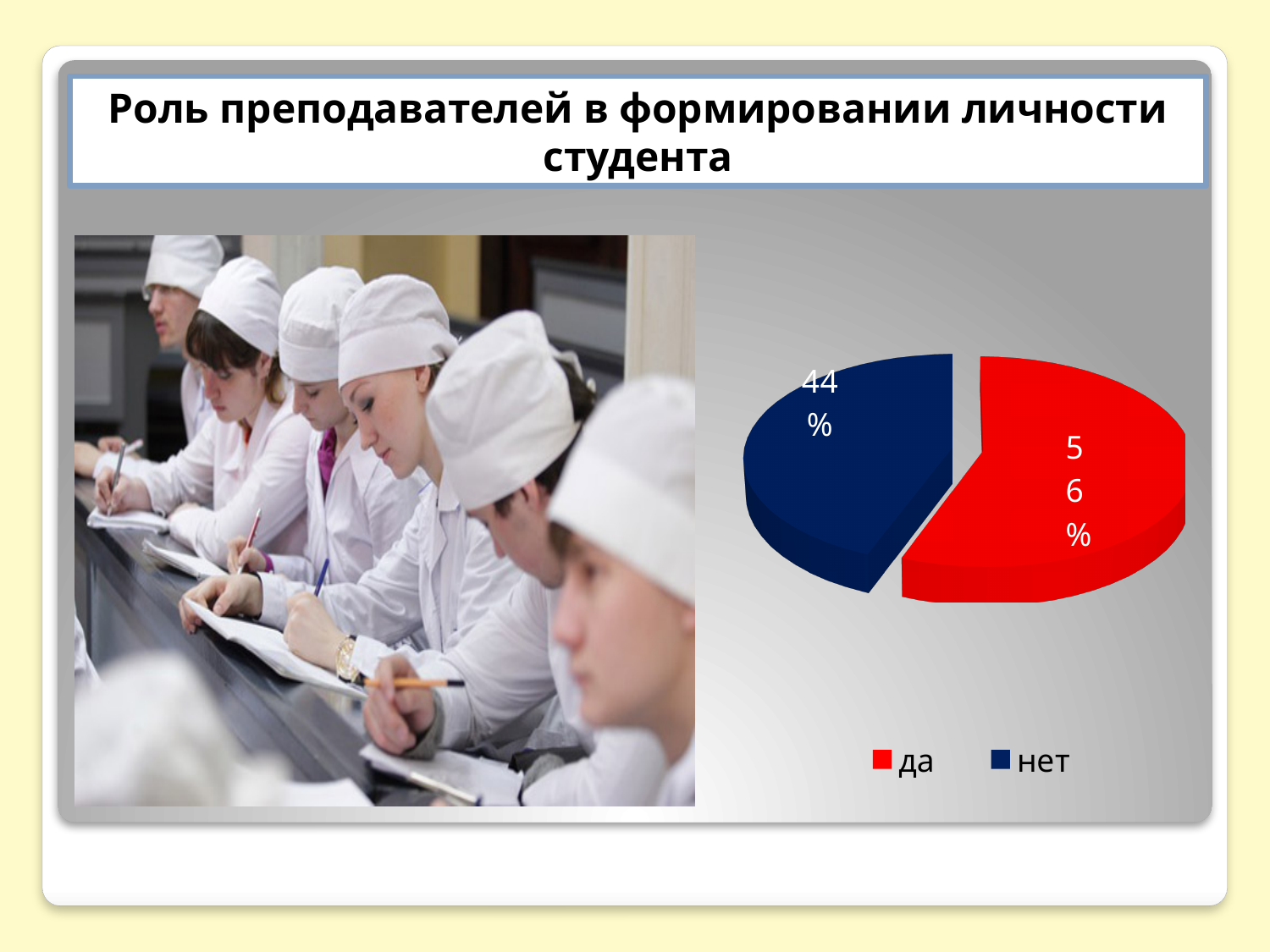
Which slice of the pie chart is the smallest? нет Is the share of the "да" slice greater or less than 50%? greater What is the difference in percentage points between the "да" and "нет" slices? 12 What colour is the "да" slice in the pie chart? red What colour is the "нет" slice in the pie chart? dark blue How many slices does the pie chart have? 2 What percentage of the pie chart is labelled "да"? 56% Which slice of the pie chart is the largest? да Which is larger in the pie chart, "да" or "нет"? да What percentage of the pie chart is labelled "нет"? 44% How many entries does the legend of the pie chart list? 2 What kind of chart is shown on the slide? pie chart